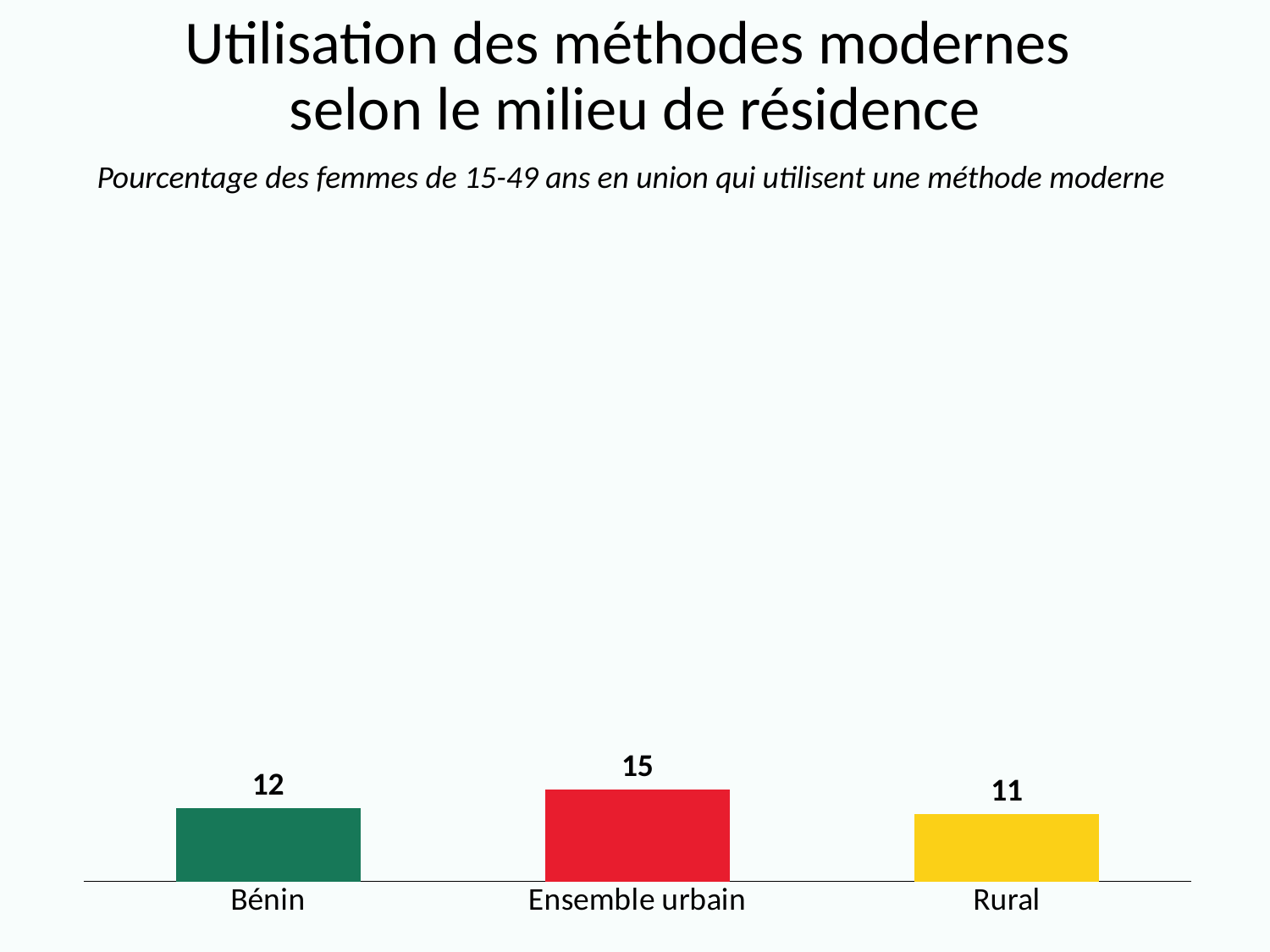
What is the value for Rural? 11 How many categories are shown on the chart? 3 What kind of chart is shown on the slide? Bar chart What is the difference between the values for Bénin and Rural? 1 What colour is the bar for Rural? Yellow What is the value for Ensemble urbain? 15 Which category has the highest value? Ensemble urbain What is the difference between the values for Ensemble urbain and Rural? 4 What is the value for Bénin? 12 What is the title of the chart? Utilisation des méthodes modernes selon le milieu de résidence Which is larger, the value for Ensemble urbain or the value for Bénin? Ensemble urbain Which category has the lowest value? Rural